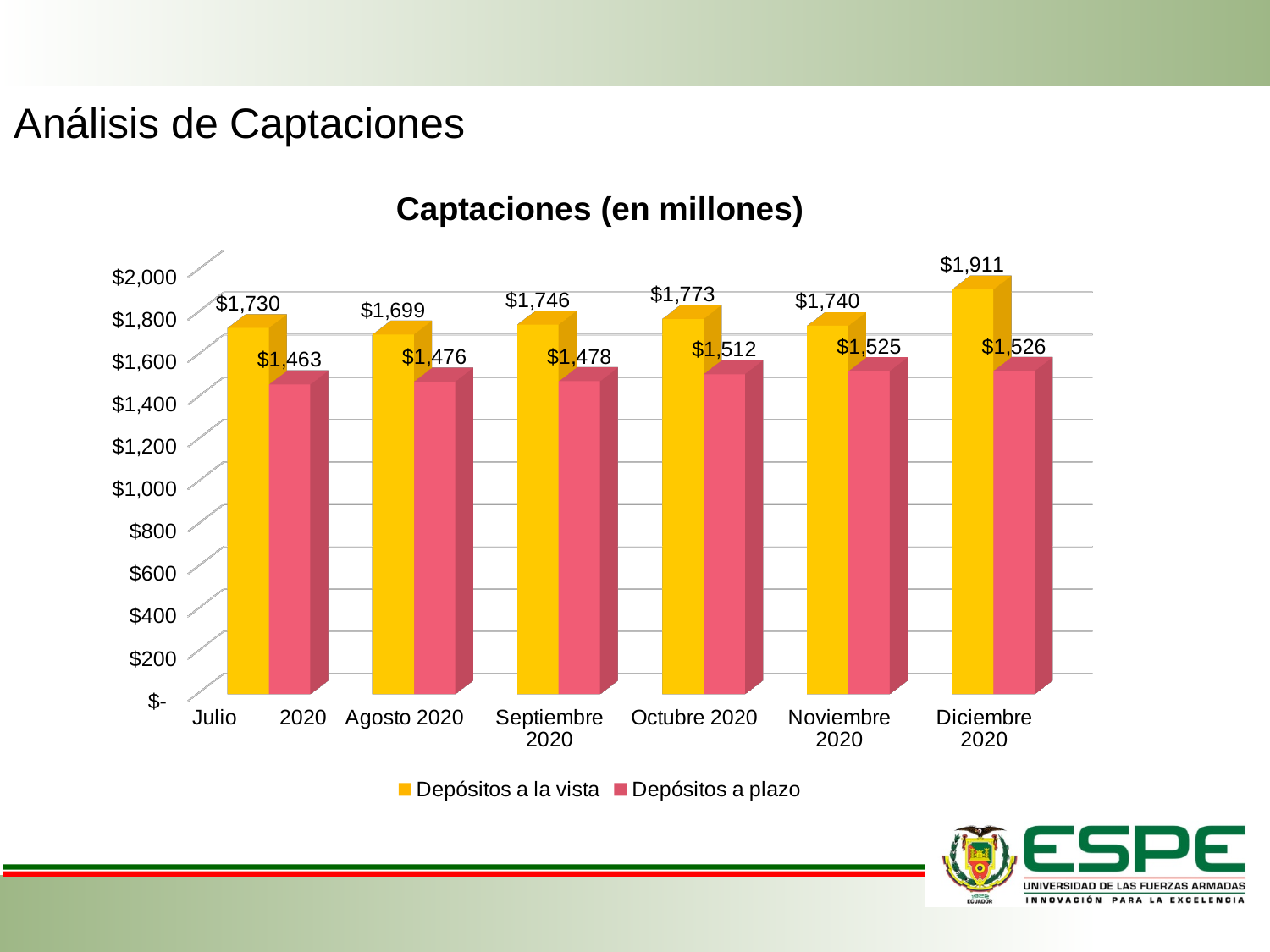
What is the title of the chart? Captaciones (en millones) What is the difference between Depósitos a la vista and Depósitos a plazo in Octubre 2020? $261 What kind of chart is shown on the slide? Bar chart Do the values for Depósitos a plazo rise or fall from Julio 2020 to Diciembre 2020? Rise Which month has the highest value for Depósitos a la vista? Diciembre 2020 How many series does the legend list? 2 What is the value of Depósitos a plazo for Julio 2020? $1,463 Which is larger in Noviembre 2020: Depósitos a la vista or Depósitos a plazo? Depósitos a la vista Which month has the lowest value for Depósitos a plazo? Julio 2020 What is the value of Depósitos a la vista for Agosto 2020? $1,699 What is the value of Depósitos a la vista for Diciembre 2020? $1,911 How many months are shown on the x axis? 6